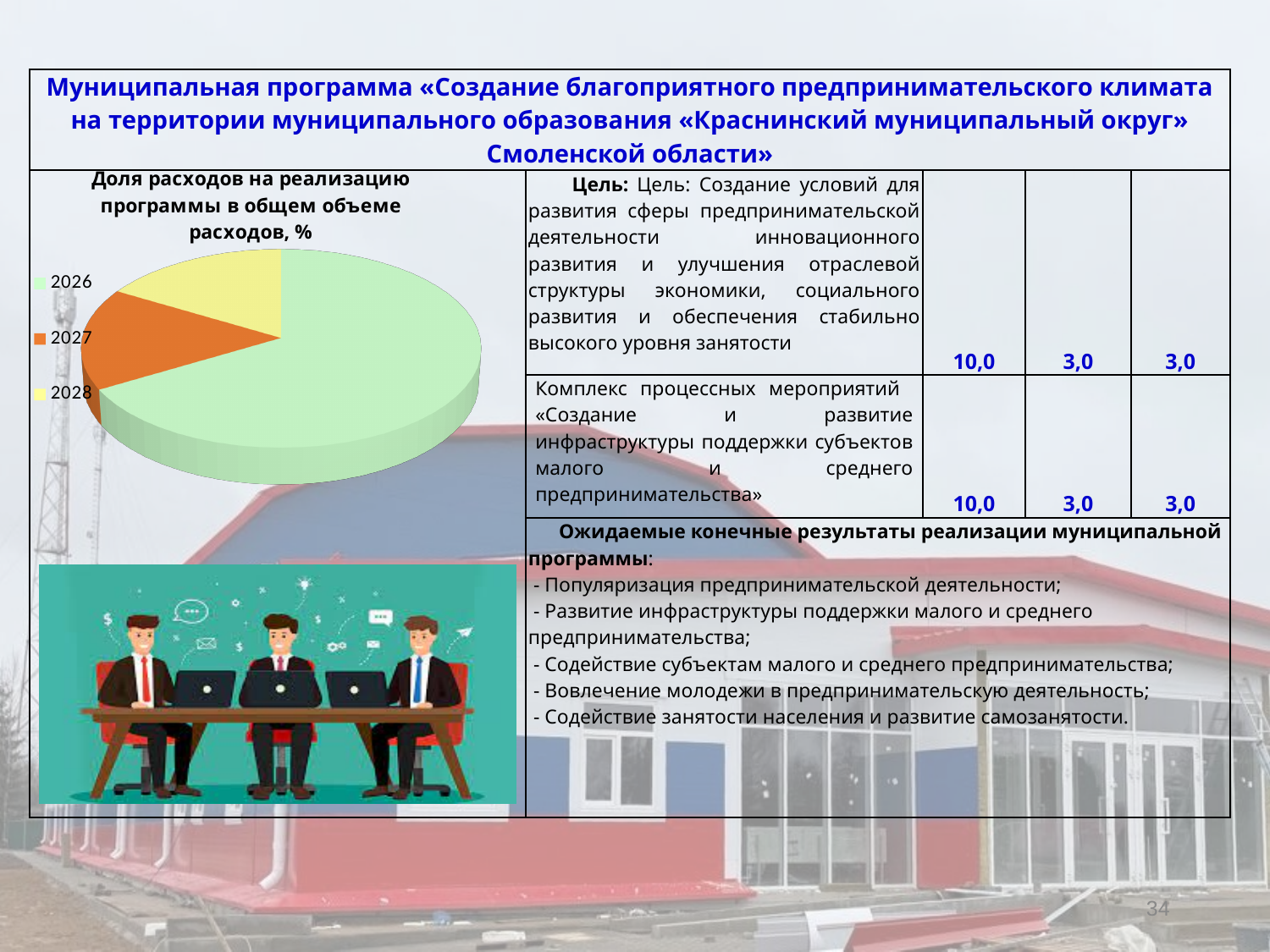
What is the title of the pie chart? Доля расходов на реализацию программы в общем объеме расходов, % Is the share of the 2028 slice in the pie chart greater or less than 50%? less Which slice is larger in the pie chart, 2026 or 2028? 2026 What kind of chart is shown on the slide? pie chart Which years are listed in the legend of the pie chart? 2026, 2027, 2028 Which slice is larger in the pie chart, 2026 or 2027? 2026 Which category has the largest slice in the pie chart? 2026 How many categories does the pie chart's legend list? 3